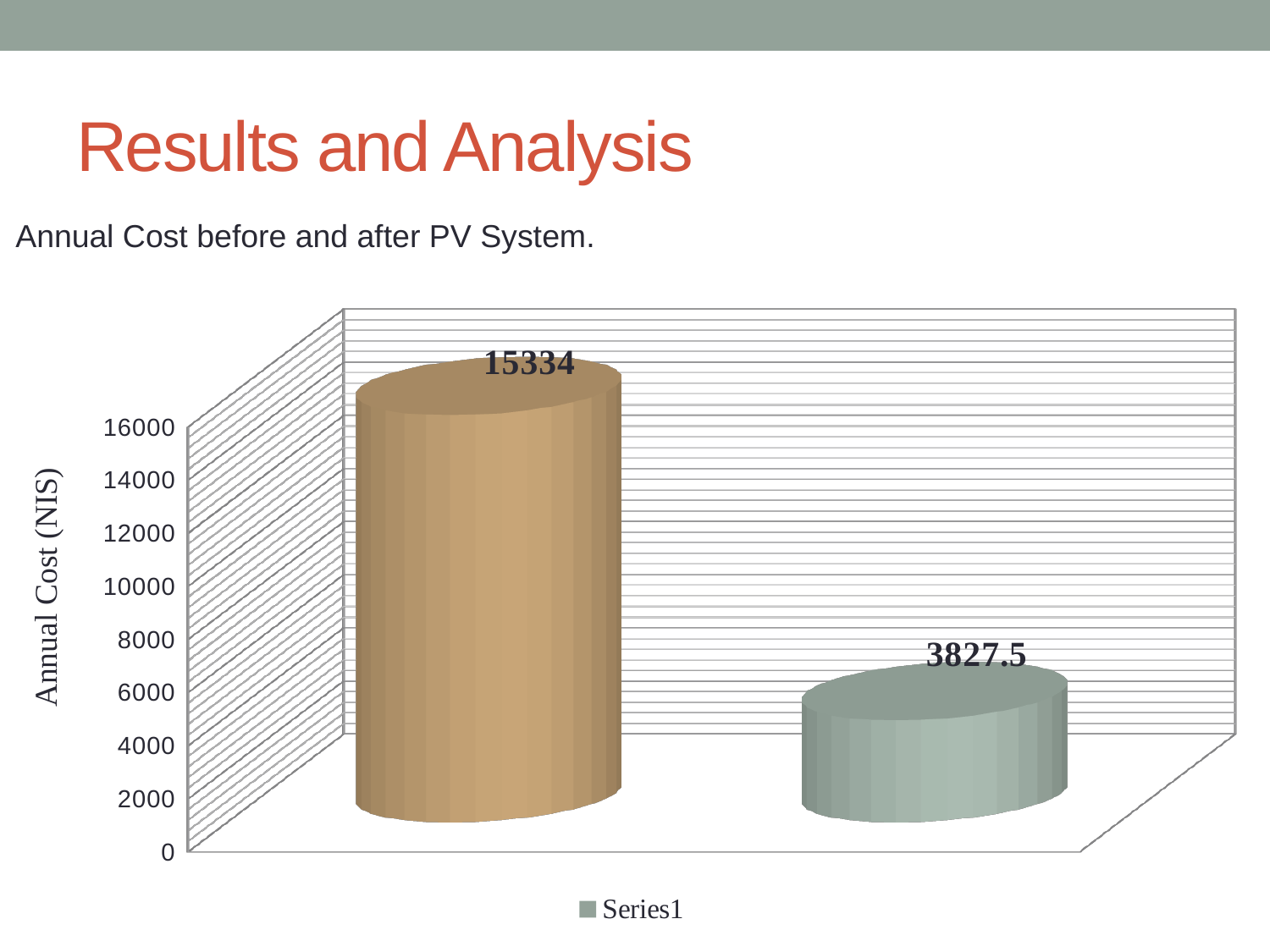
What is the label of the vertical axis? Annual Cost (NIS) Is the value of the right bar greater or less than 4000? less Which bar is taller, the left one or the right one? the left one What is the difference between the left bar's value and the right bar's value? 11506.5 What kind of chart is shown on the slide? bar chart Is the value of the left bar greater or less than 14000? greater What value is shown on the right (grey-green) bar? 3827.5 What value is shown on the left (tan) bar? 15334 What is the highest value shown on the vertical axis? 16000 How many bars are plotted in the chart? 2 How many series does the legend list? 1 What series name appears in the legend? Series1